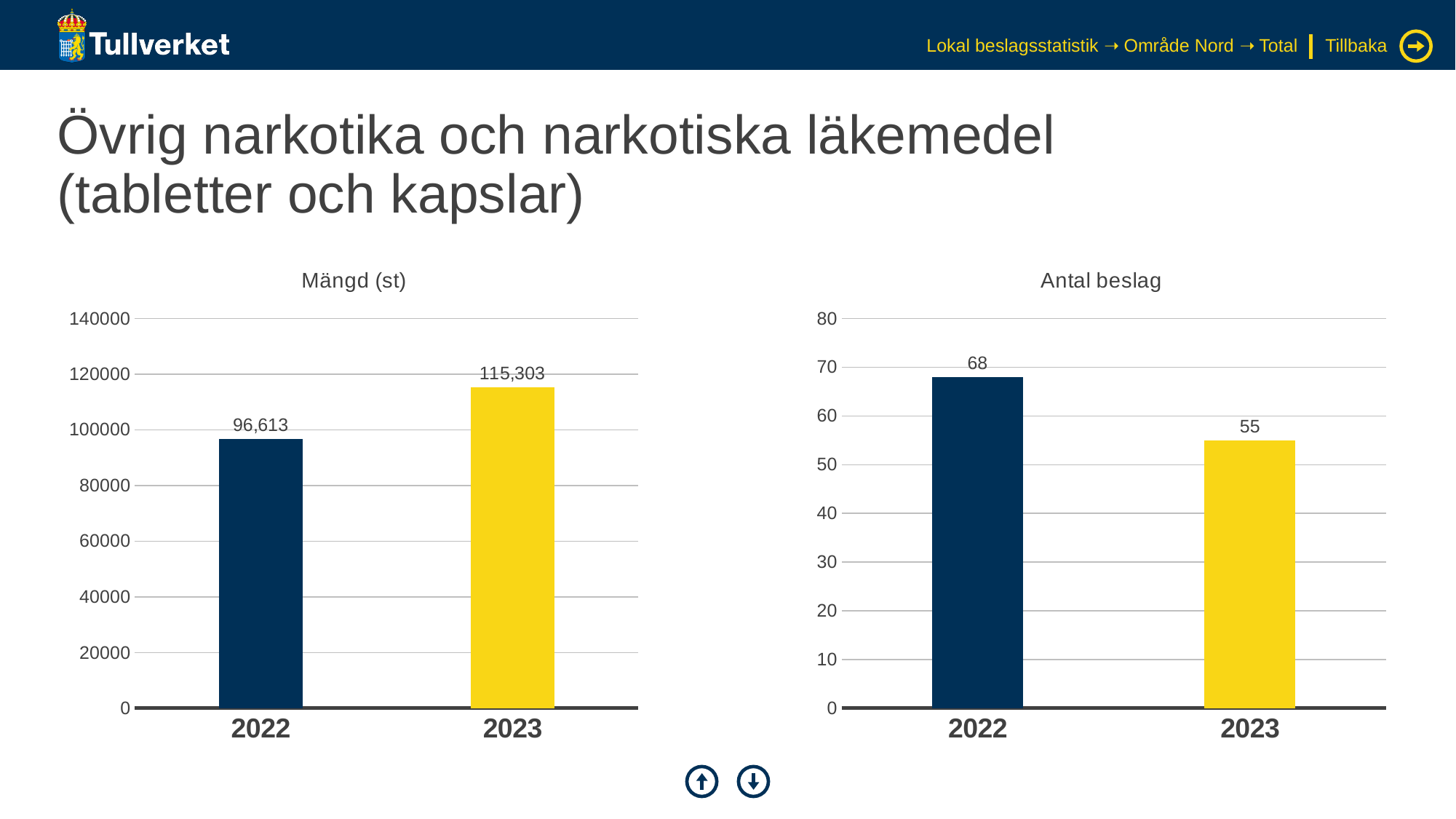
In the 'Antal beslag' chart, is the value for 2022 greater or less than 60? greater In the 'Mängd (st)' chart, what is the value for 2023? 115,303 What kind of chart is the 'Antal beslag' chart? bar chart In the 'Antal beslag' chart, what is the difference between the 2022 and 2023 values? 13 How many years are shown in the 'Mängd (st)' chart? 2 In the 'Mängd (st)' chart, what is the value for 2022? 96,613 In the 'Mängd (st)' chart, do the values rise or fall from 2022 to 2023? rise In the 'Antal beslag' chart, what is the value for 2023? 55 In the 'Antal beslag' chart, which year has the lower value? 2023 In the 'Antal beslag' chart, what is the value for 2022? 68 In the 'Mängd (st)' chart, which year has the higher value? 2023 In the 'Mängd (st)' chart, what is the difference between the 2023 and 2022 values? 18,690